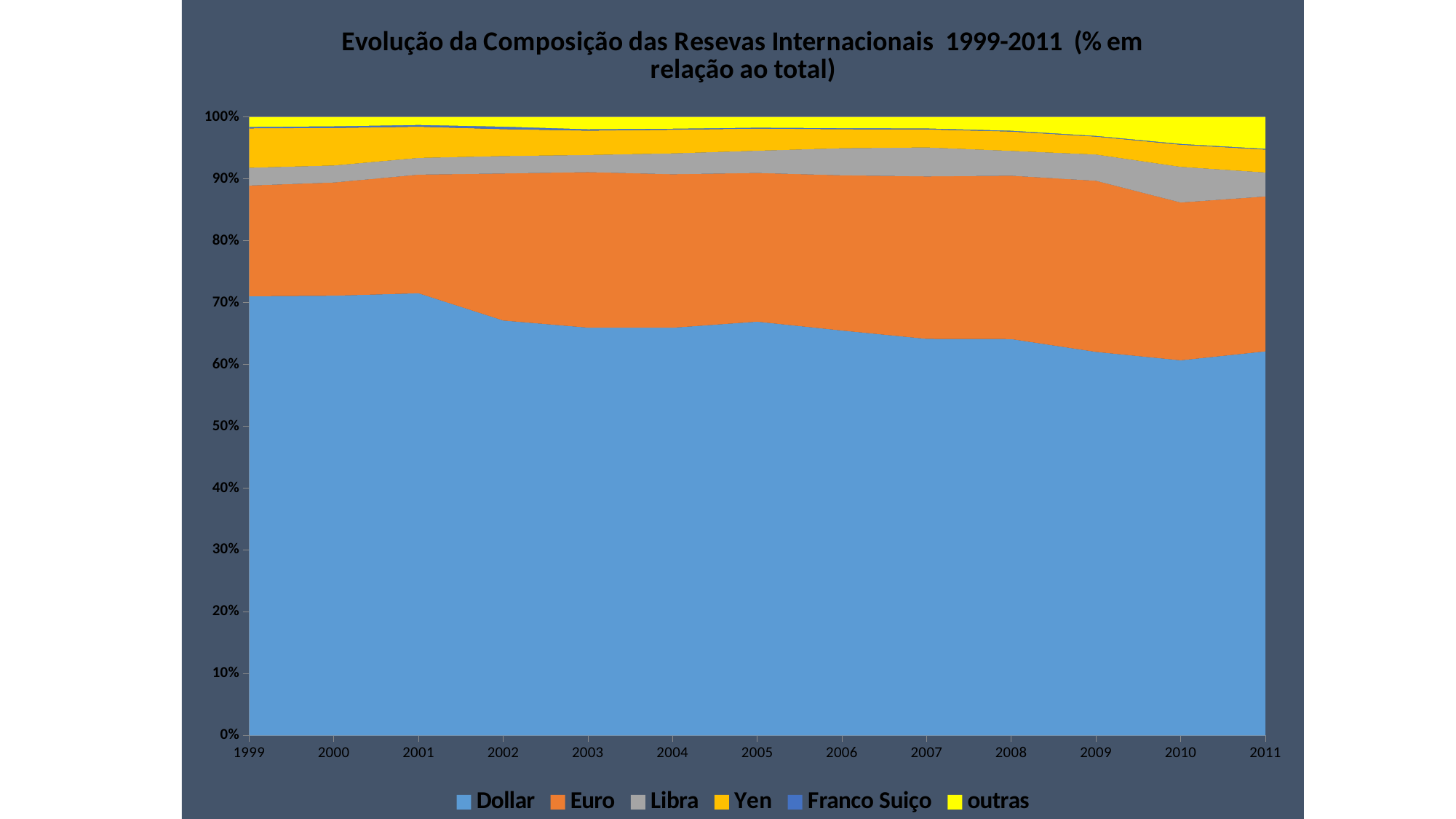
How many series does the legend list? 6 Which series is shown in yellow at the top of the chart? outras What is the title of the chart? Evolução da Composição das Resevas Internacionais 1999-2011 (% em relação ao total) How many years are plotted along the x axis? 13 Does the Dollar's share of reserves rise or fall from 1999 to 2011? Fall Is the Dollar's share in 2005 greater or less than 70%? less Is the Dollar's share in 2005 greater or less than 60%? greater Which currency in the legend has the smallest share of reserves? Franco Suiço Is the Dollar's share in 2010 greater or less than 70%? less Which currency accounts for the largest share of reserves throughout the period? Dollar What kind of chart is shown on the slide? Stacked area chart Was the Dollar's share of reserves larger in 1999 or in 2010? 1999